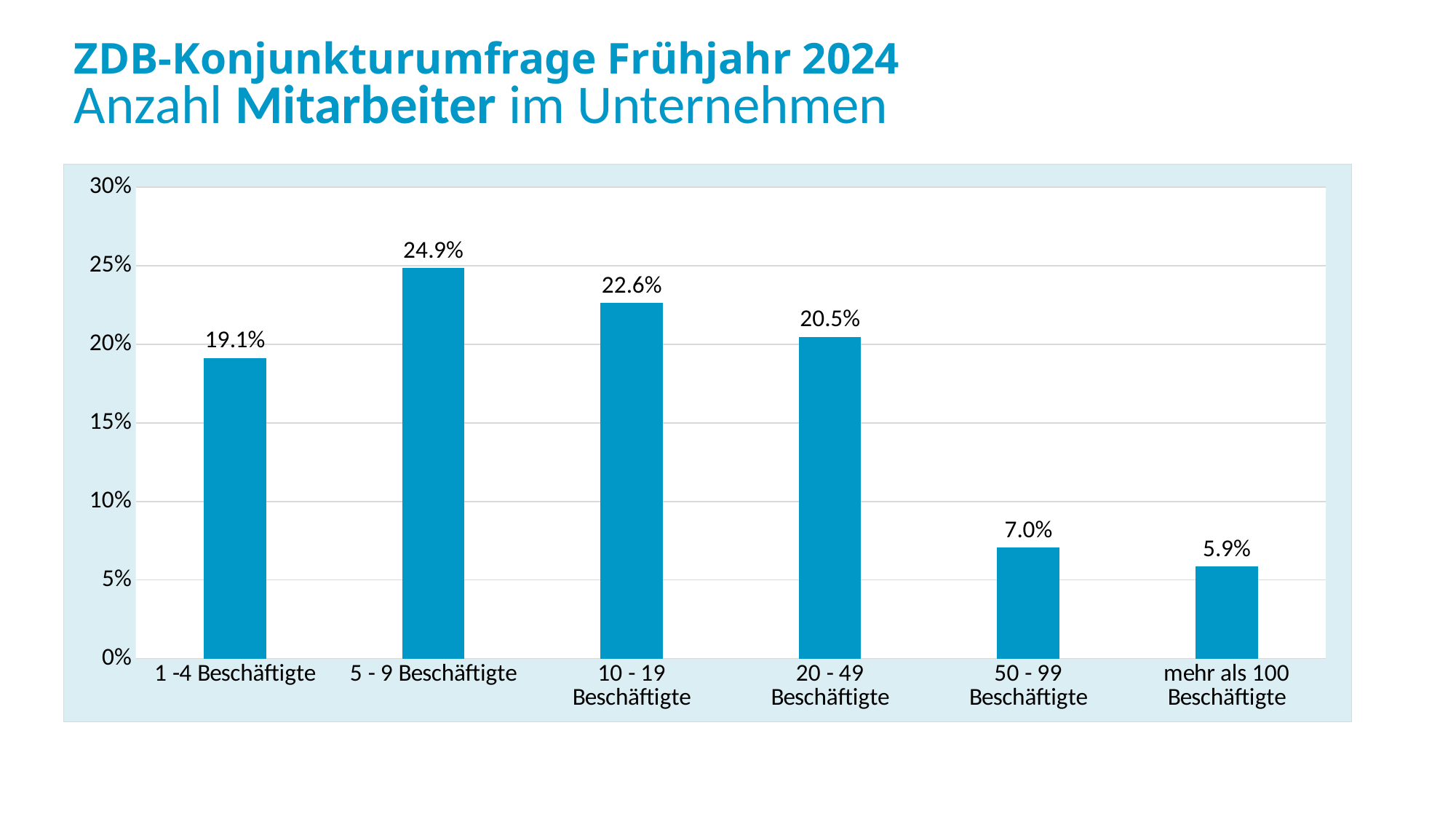
Which category has the lowest value? mehr als 100 Beschäftigte Is the value for 1 -4 Beschäftigte greater or less than 20%? less Which is larger, the value for 10 - 19 Beschäftigte or the value for 20 - 49 Beschäftigte? 10 - 19 Beschäftigte How many categories are shown on the x axis? 6 Which category has the highest value? 5 - 9 Beschäftigte What is the value for mehr als 100 Beschäftigte? 5.9% What kind of chart is shown on the slide? bar chart What is the difference between the values for 50 - 99 Beschäftigte and mehr als 100 Beschäftigte? 1.1% What is the difference between the values for 5 - 9 Beschäftigte and 1 -4 Beschäftigte? 5.8% What is the value for 5 - 9 Beschäftigte? 24.9% What is the title of the slide? ZDB-Konjunkturumfrage Frühjahr 2024 Anzahl Mitarbeiter im Unternehmen What is the value for 20 - 49 Beschäftigte? 20.5%